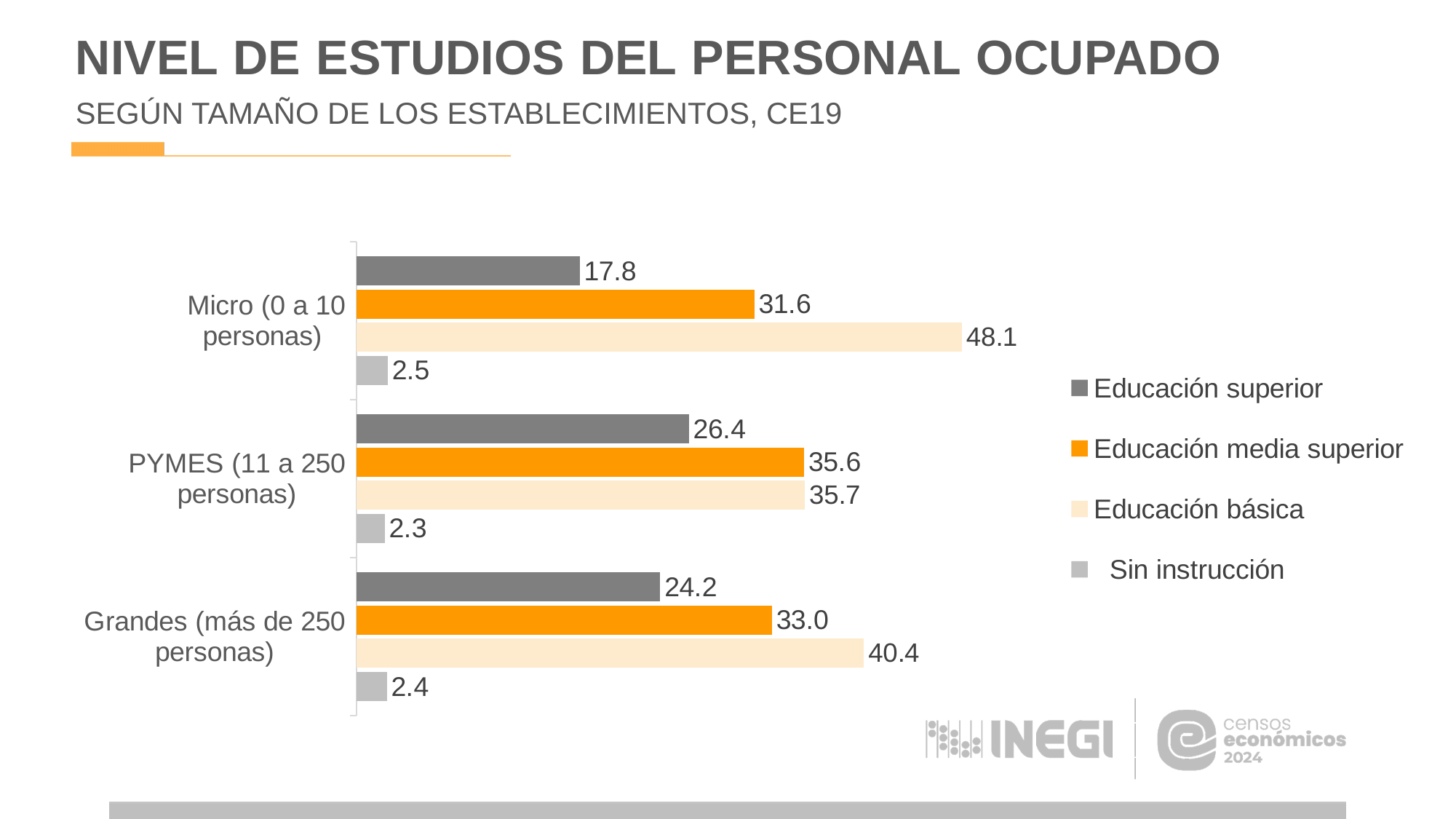
Which is larger for Grandes (más de 250 personas): Educación media superior or Educación superior? Educación media superior What is the value for Educación superior in the Micro (0 a 10 personas) category? 17.8 What is the value for Sin instrucción in the PYMES (11 a 250 personas) category? 2.3 What is the value for Educación básica in the Grandes (más de 250 personas) category? 40.4 What is the difference between Educación media superior for PYMES (11 a 250 personas) and for Micro (0 a 10 personas)? 4.0 Which series is shown in orange in the legend? Educación media superior Which category has the lowest value for Educación superior? Micro (0 a 10 personas) What kind of chart is shown on the slide? Bar chart Which category has the highest value for Educación básica? Micro (0 a 10 personas) How many series does the legend list? 4 How many establishment size categories are shown on the chart? 3 What is the difference between Educación básica and Educación superior for Micro (0 a 10 personas)? 30.3